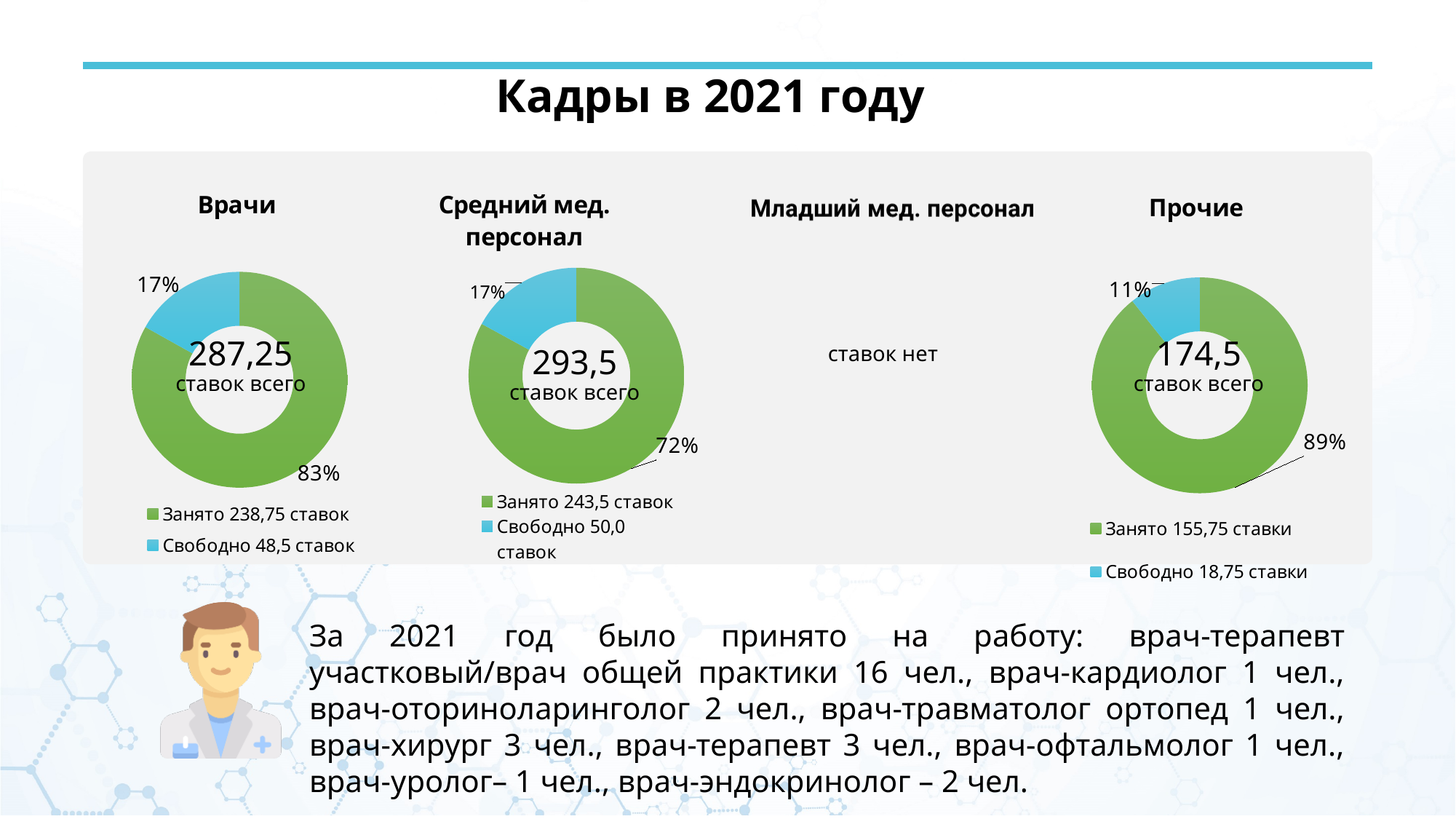
What kind of chart is used for the "Врачи" section? Donut (pie) chart In the "Врачи" chart, how many ставок are listed as "Свободно" in the legend? 48,5 ставок Which of the three donut charts has the largest total number of ставок shown in its centre? Средний мед. персонал How many legend entries does the "Прочие" chart list? 2 Which of the three donut charts has the smallest total number of ставок shown in its centre? Прочие In the "Средний мед. персонал" chart, what percentage is labelled on the "Свободно" slice? 17% What total number of ставок is shown in the centre of the "Средний мед. персонал" chart? 293,5 In the "Средний мед. персонал" chart, how many ставок are listed as "Занято" in the legend? 243,5 ставок What total number of ставок is shown in the centre of the "Врачи" chart? 287,25 In the "Прочие" chart, what percentage is labelled on the "Занято" slice? 89% In the "Прочие" chart, how many ставки are listed as "Свободно" in the legend? 18,75 ставки In the "Врачи" chart, what percentage share is labelled for the "Занято" slice? 83%